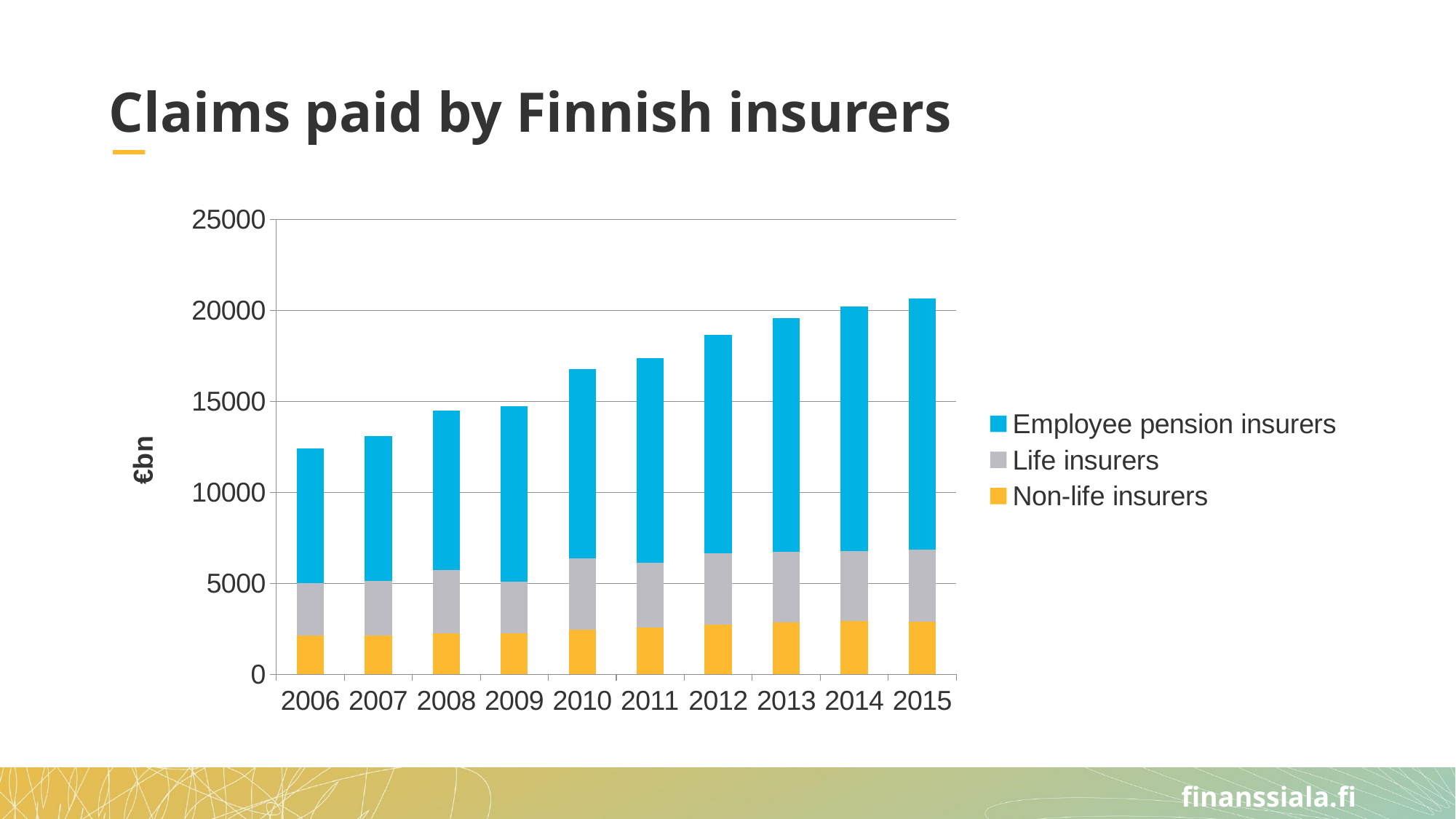
How many years are shown on the x axis? 10 Which year has the lowest total claims paid? 2006 Which series is shown in blue? Employee pension insurers What unit is shown on the y axis label? €bn Do total claims paid rise or fall from 2006 to 2015? Rise Is the total value for 2006 greater or less than 15000? less Which year has the highest total claims paid? 2015 How many series does the legend list? 3 Is the total value for 2010 greater or less than 15000? greater Is the total value for 2012 greater or less than 20000? less What kind of chart is shown on the slide? Stacked bar chart